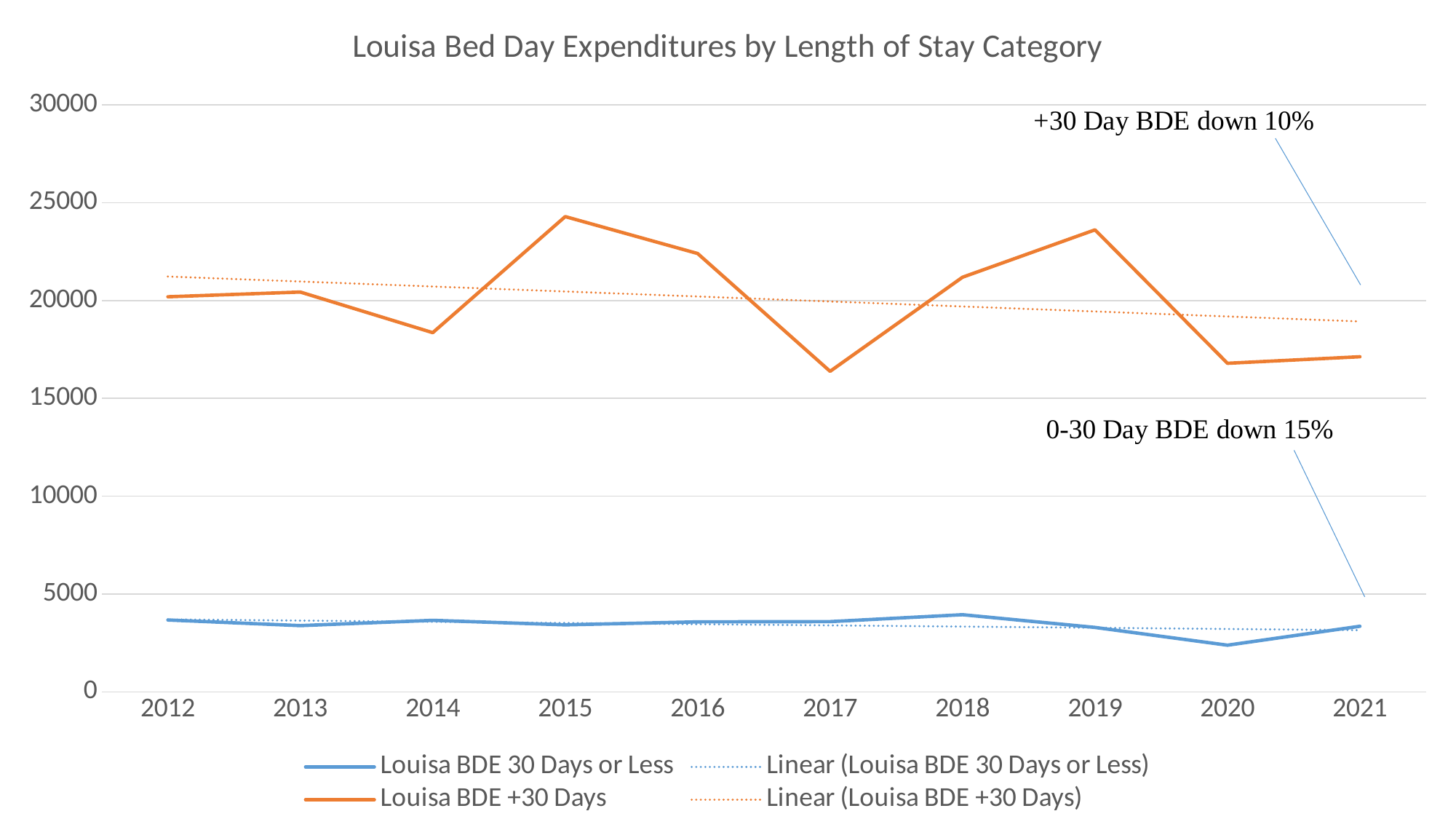
Is the Louisa BDE +30 Days value for 2015 greater or less than 20000? greater How many years are shown on the x axis? 10 Is the Louisa BDE +30 Days value for 2017 greater or less than 20000? less In which year is the Louisa BDE 30 Days or Less value lowest? 2020 In which year is the Louisa BDE +30 Days value highest? 2015 What kind of chart is shown on the slide? line chart According to the annotation on the chart, by what percentage is the 0-30 Day BDE down? 15% In which year is the Louisa BDE 30 Days or Less value highest? 2018 How many entries does the legend list? 4 What is the title of the chart? Louisa Bed Day Expenditures by Length of Stay Category Which is larger for Louisa BDE +30 Days: the value in 2019 or the value in 2020? 2019 Is the Louisa BDE 30 Days or Less value for 2018 greater or less than 5000? less